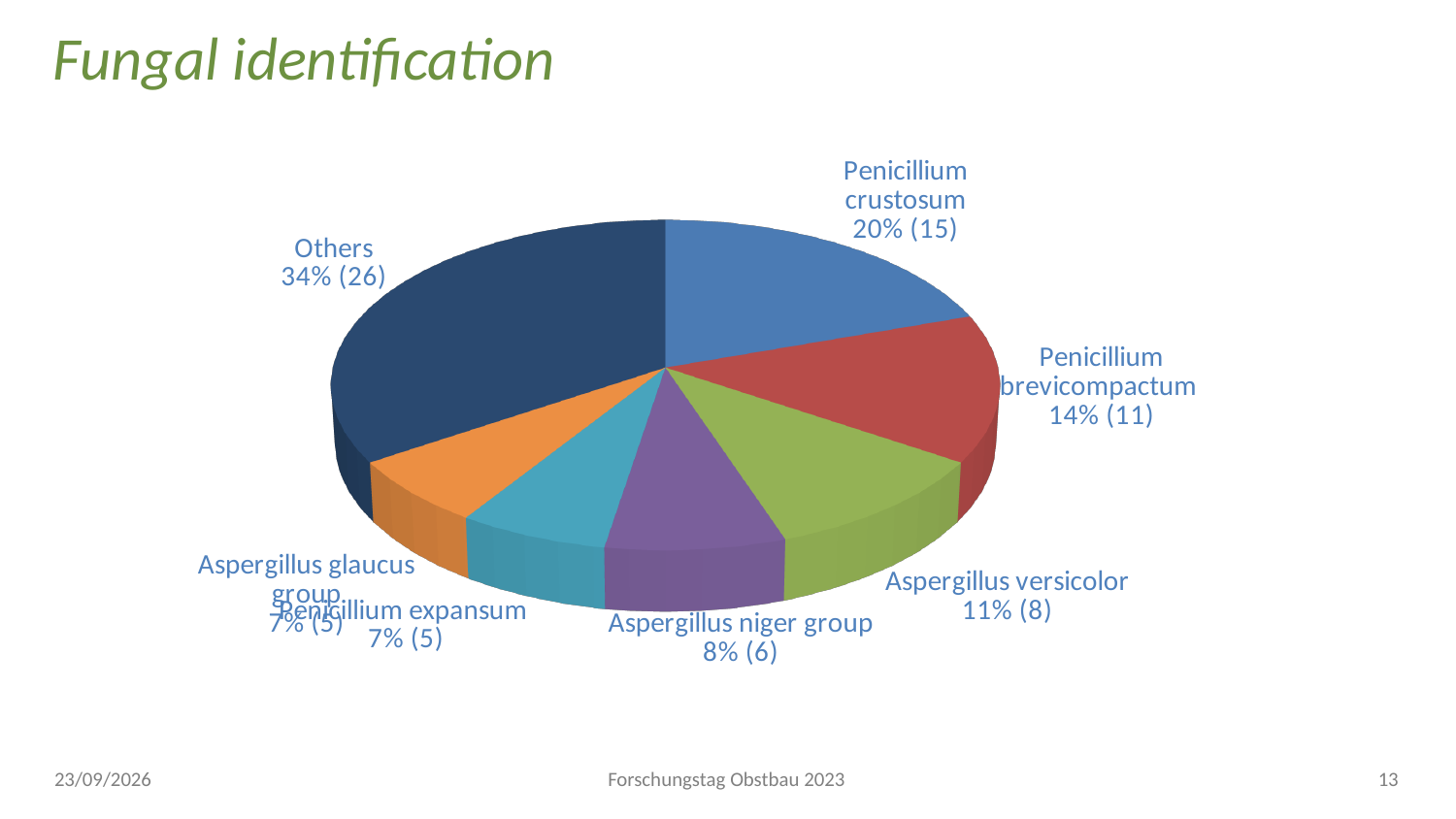
What is the difference in count between Others and Penicillium crustosum? 11 What is the title of the slide containing the pie chart? Fungal identification What share of the pie does the Others slice represent? 34% What percentage is shown for Penicillium expansum? 7% What is the count shown for Penicillium brevicompactum? 11 How many slices does the pie chart have? 7 Which slice of the pie is the largest? Others What is the count shown for Aspergillus niger group? 6 What percentage is shown for Aspergillus versicolor? 11% What kind of chart is shown on the slide? pie chart What share of the pie does Penicillium crustosum account for? 20% Which is larger, Penicillium crustosum or Penicillium brevicompactum? Penicillium crustosum